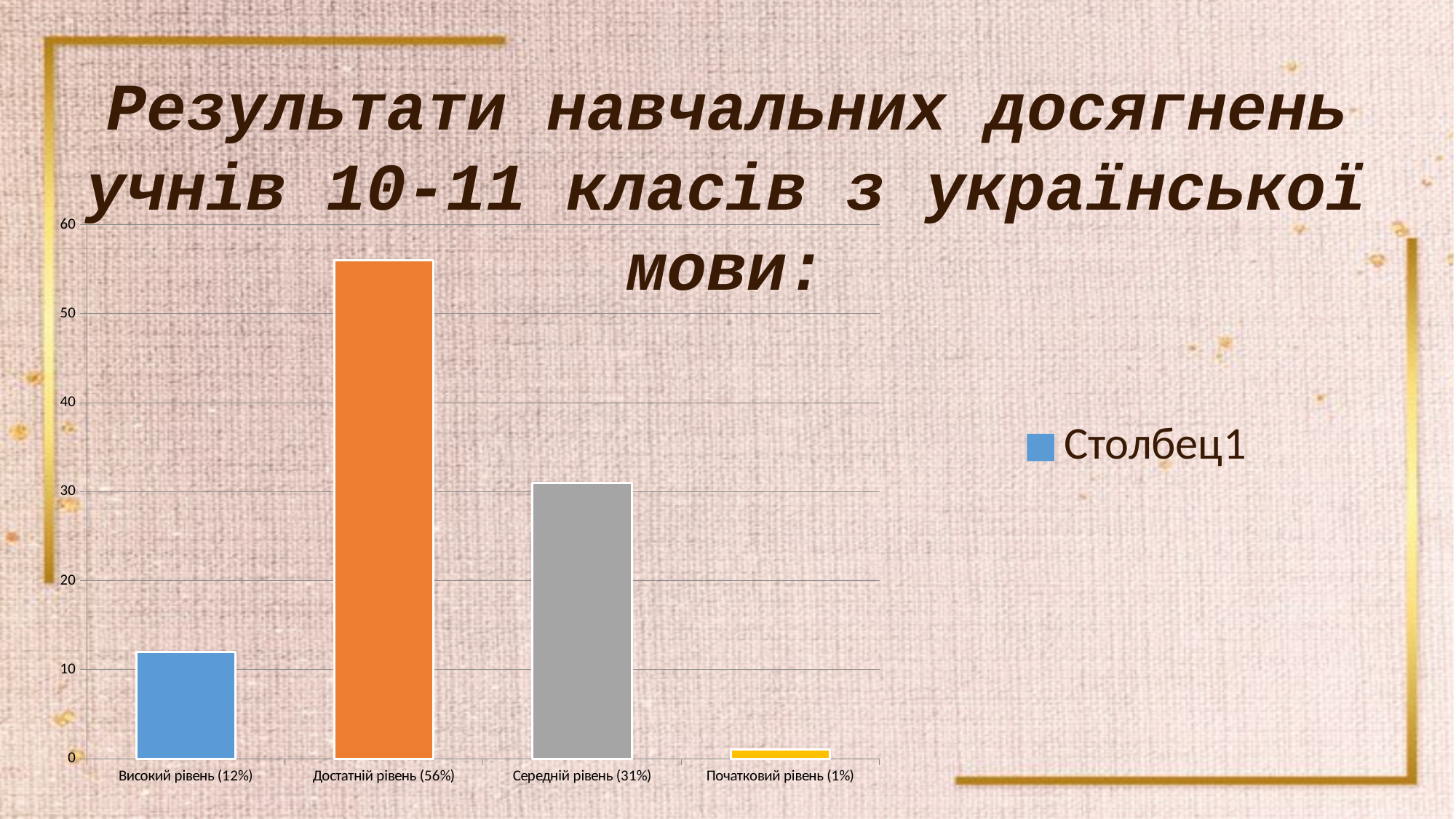
What percentage is shown for Високий рівень? 12% How many categories are plotted in the chart? 4 What is the difference between the values for Достатній рівень and Середній рівень? 25% How many series does the legend list? 1 Which category has the highest value? Достатній рівень What is the legend entry for the series in the chart? Столбец1 What percentage is shown for Початковий рівень? 1% What percentage is shown for Достатній рівень? 56% What percentage is shown for Середній рівень? 31% Which category has the lowest value? Початковий рівень What kind of chart is shown on the slide? bar chart Which is larger, the value for Високий рівень or the value for Середній рівень? Середній рівень